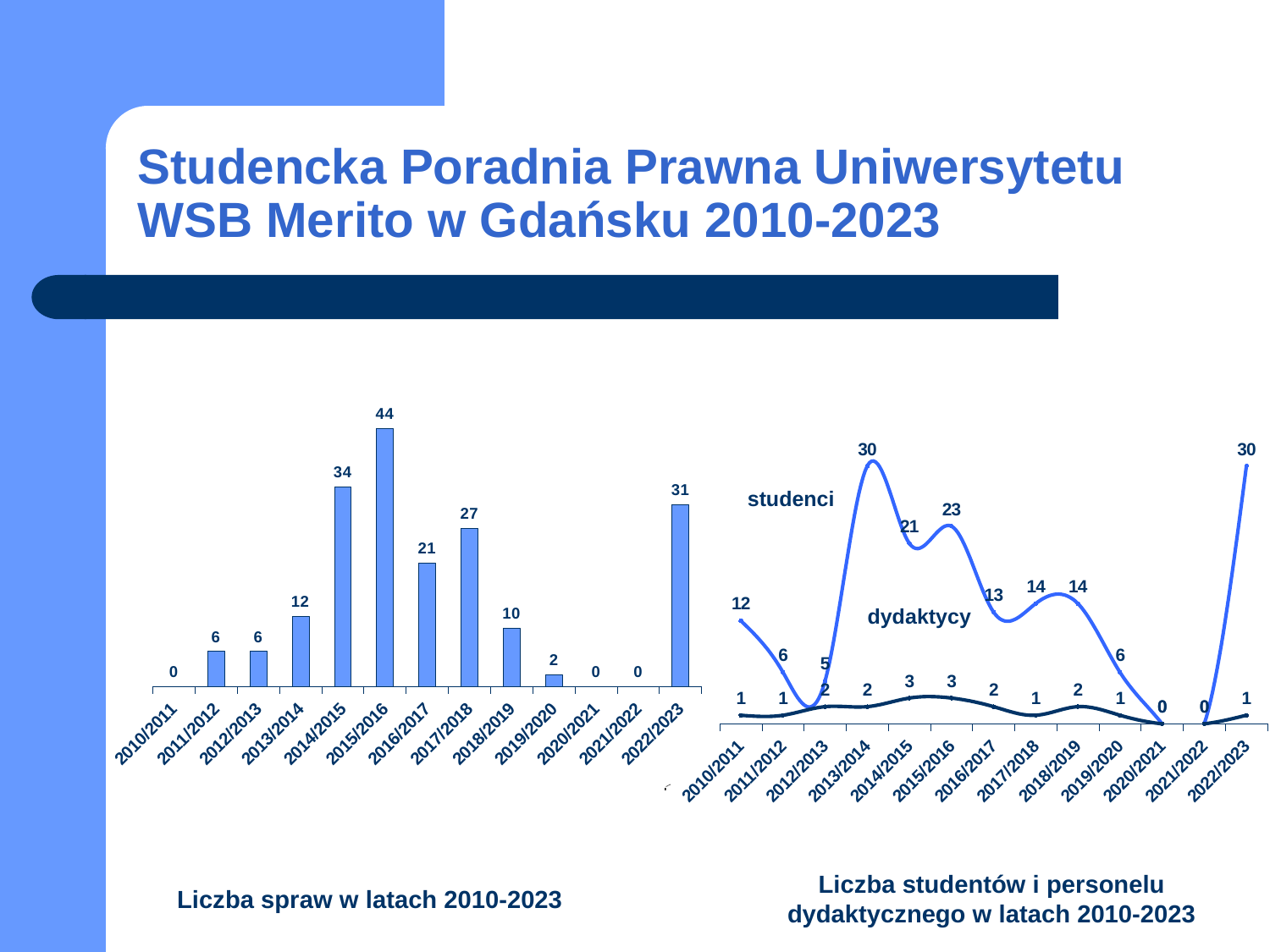
In the chart 'Liczba studentów i personelu dydaktycznego w latach 2010-2023', how many series are plotted? 2 What kind of chart is 'Liczba spraw w latach 2010-2023'? bar chart In the chart 'Liczba spraw w latach 2010-2023', what is the value for 2015/2016? 44 In the chart 'Liczba spraw w latach 2010-2023', what is the value for 2022/2023? 31 In the chart 'Liczba studentów i personelu dydaktycznego w latach 2010-2023', what is the value for studenci in 2013/2014? 30 In the chart 'Liczba spraw w latach 2010-2023', what is the difference between the values for 2014/2015 and 2017/2018? 7 In the chart 'Liczba spraw w latach 2010-2023', how many years are shown on the x axis? 13 In the chart 'Liczba studentów i personelu dydaktycznego w latach 2010-2023', what is the value for dydaktycy in 2014/2015? 3 In the chart 'Liczba studentów i personelu dydaktycznego w latach 2010-2023', which is larger in 2016/2017: studenci or dydaktycy? studenci In the chart 'Liczba studentów i personelu dydaktycznego w latach 2010-2023', what is the difference between studenci and dydaktycy in 2015/2016? 20 In the chart 'Liczba spraw w latach 2010-2023', which year has the highest value? 2015/2016 What kind of chart is 'Liczba studentów i personelu dydaktycznego w latach 2010-2023'? line chart